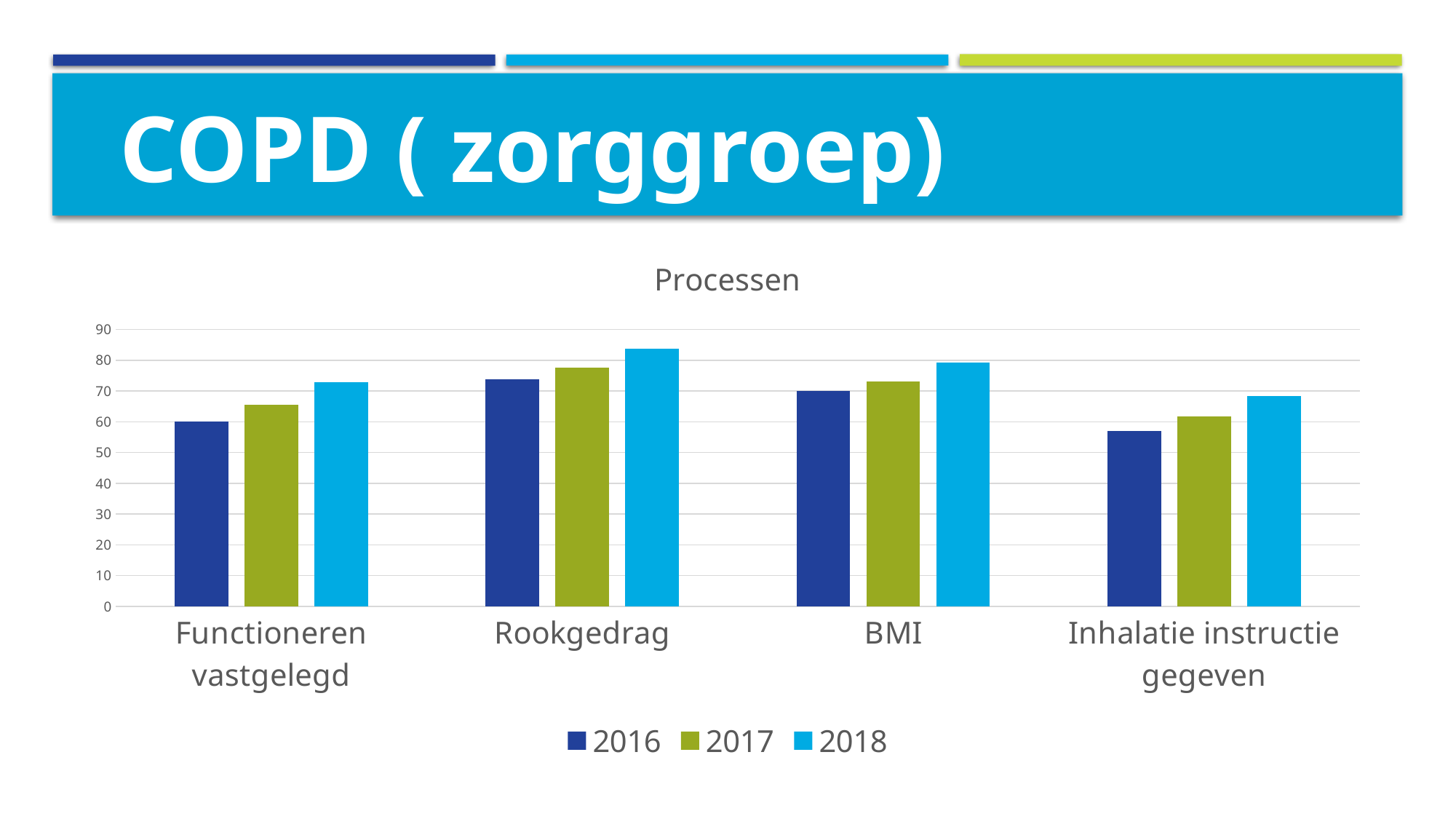
What is the title of the chart? Processen How many categories are shown on the x axis? 4 Is the value for Inhalatie instructie gegeven in 2016 greater or less than 60? less Which category has the highest value for 2018? Rookgedrag Is the value for Rookgedrag in 2018 greater or less than 80? greater Is the value for Rookgedrag in 2017 greater or less than 70? greater What kind of chart is shown on the slide? bar chart How many series does the legend list? 3 Which category has the lowest value for 2016? Inhalatie instructie gegeven Within each category, do the values rise or fall from 2016 to 2018? rise Which is larger for 2016: Rookgedrag or Inhalatie instructie gegeven? Rookgedrag